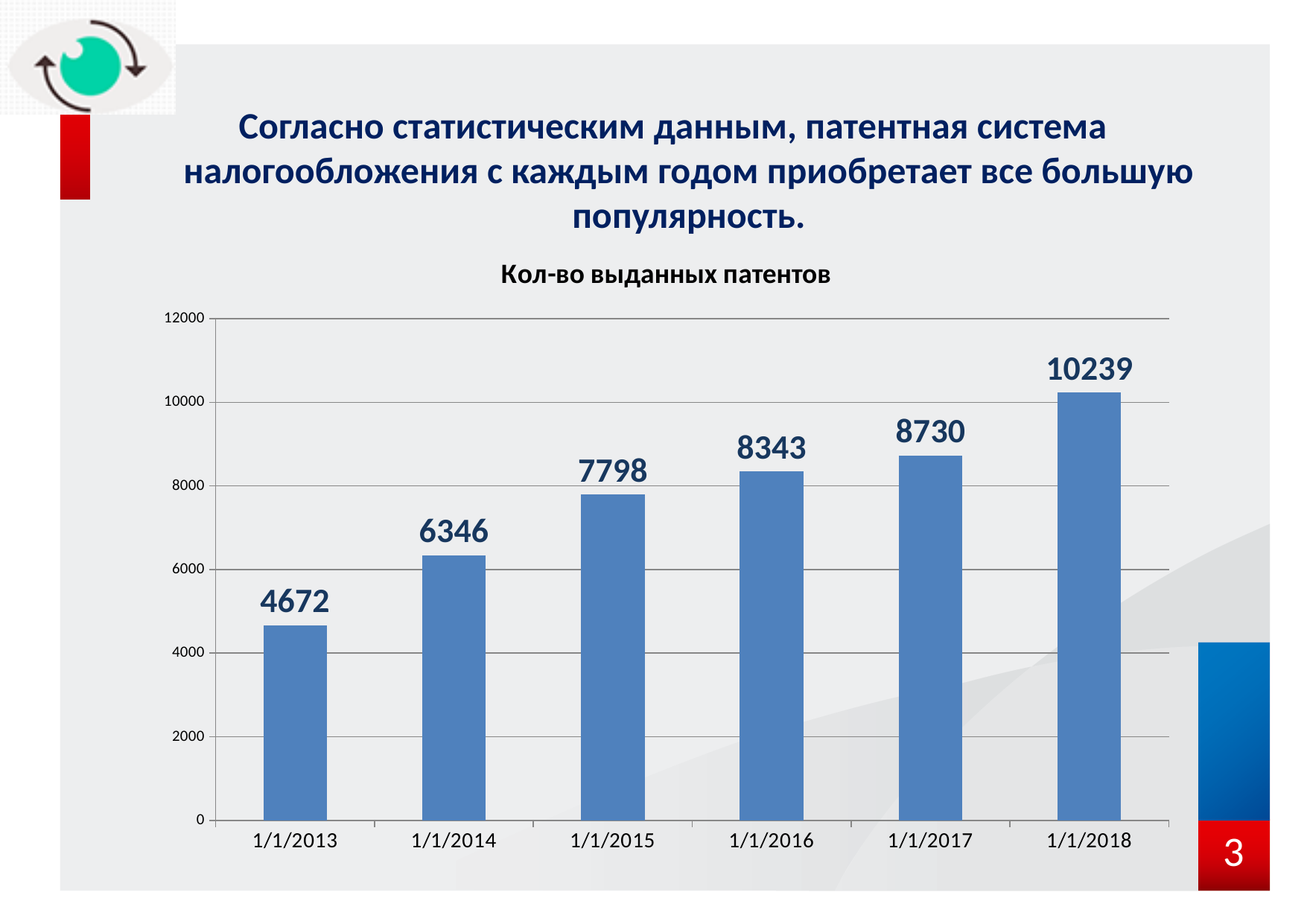
Is the value for 1/1/2017 greater or less than 8000? greater What is the difference between the values for 1/1/2018 and 1/1/2017? 1509 Which category has the lowest value? 1/1/2013 Do the values rise or fall from 1/1/2013 to 1/1/2018? rise What is the value for 1/1/2013? 4672 What kind of chart is shown on the slide? bar chart How many categories are shown on the x axis? 6 What is the difference between the values for 1/1/2014 and 1/1/2013? 1674 Which is larger, the value for 1/1/2015 or the value for 1/1/2016? 1/1/2016 What is the value for 1/1/2016? 8343 Which category has the highest value? 1/1/2018 What is the value for 1/1/2018? 10239